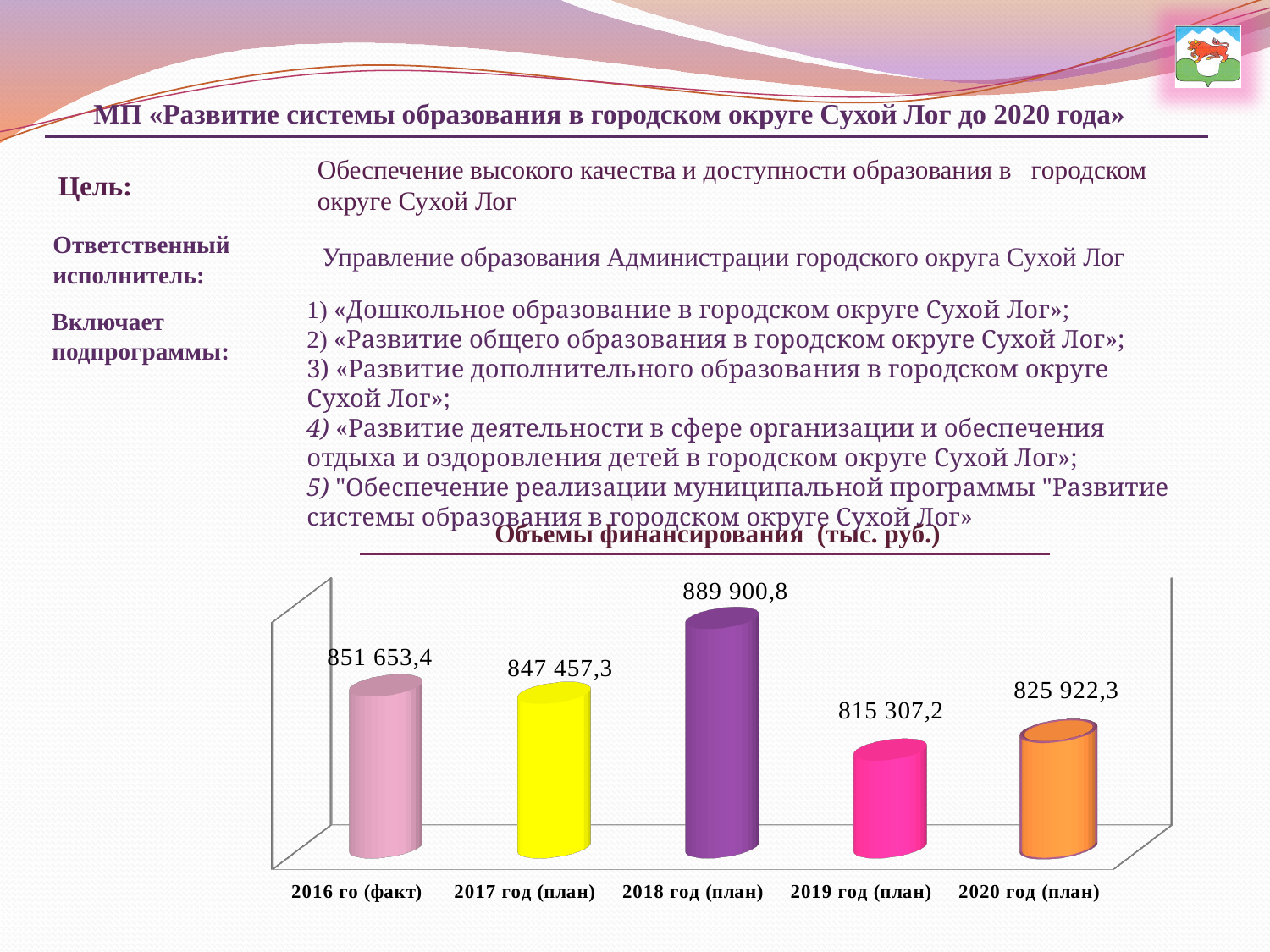
What is the value for 2018 год (план) in the chart Объемы финансирования (тыс. руб.)? 889 900,8 What is the value for 2020 год (план) in the chart? 825 922,3 Which year has the highest funding volume in the chart? 2018 год (план) What is the value for 2019 год (план) in the chart? 815 307,2 Which year has the lowest funding volume in the chart? 2019 год (план) What is the difference between the values for 2016 го (факт) and 2017 год (план)? 4 196,1 What is the title of the chart on the slide? Объемы финансирования (тыс. руб.) What kind of chart is shown on the slide? Bar chart What is the difference between the values for 2018 год (план) and 2019 год (план)? 74 593,6 How many categories (years) are shown in the chart? 5 Which is larger, the value for 2020 год (план) or the value for 2019 год (план)? 2020 год (план) What is the value for 2016 го (факт) in the chart? 851 653,4